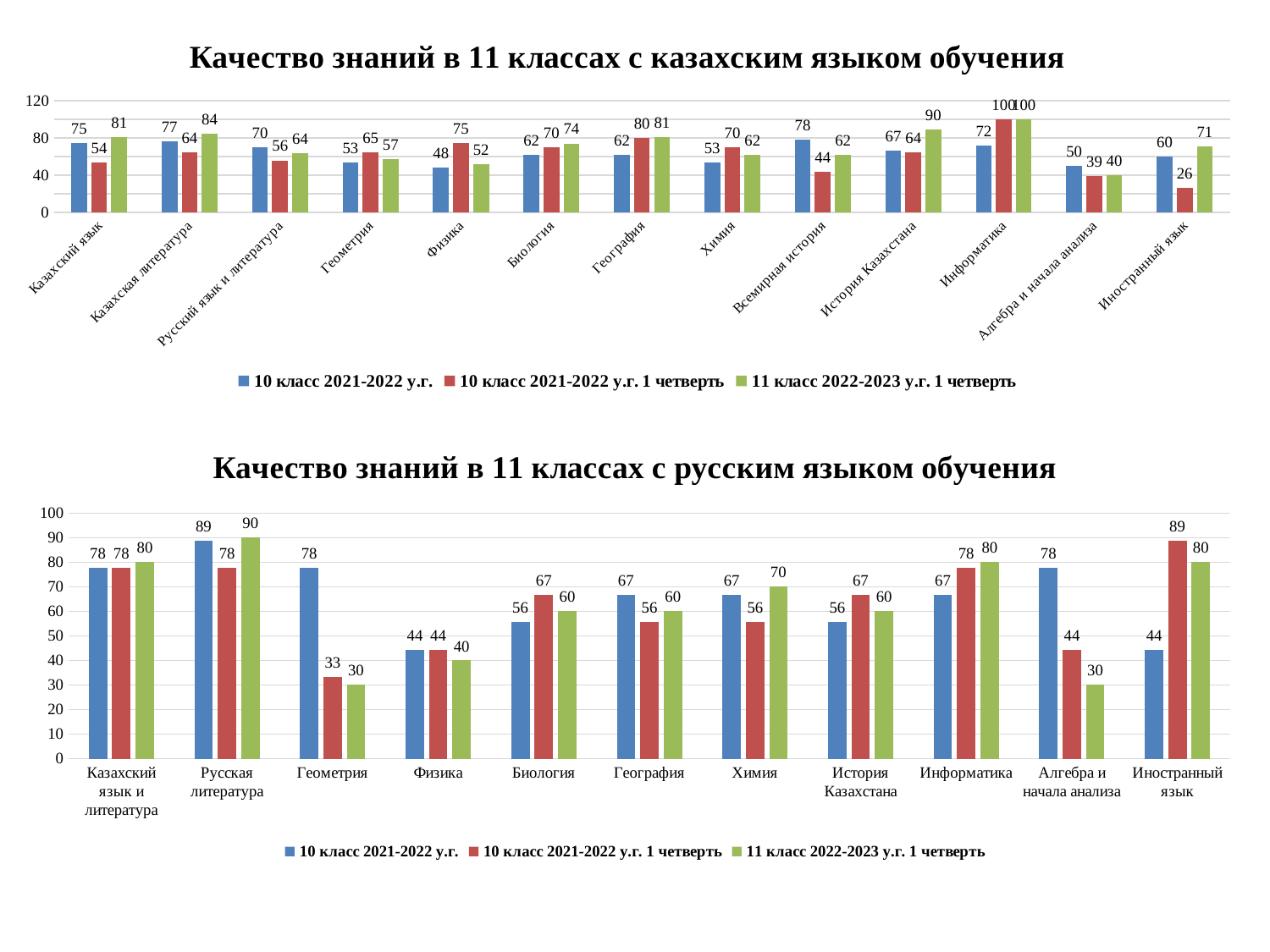
In the chart 'Качество знаний в 11 классах с казахским языком обучения', what is the value for Информатика in the series '10 класс 2021-2022 у.г.'? 72 How many series does the legend list in the chart 'Качество знаний в 11 классах с русским языком обучения'? 3 In the chart 'Качество знаний в 11 классах с казахским языком обучения', which category has the lowest value in the series '10 класс 2021-2022 у.г.'? Физика What type of chart is the bottom chart on the slide? Bar chart In the chart 'Качество знаний в 11 классах с казахским языком обучения', which category has the highest value in the series '11 класс 2022-2023 у.г. 1 четверть'? Информатика In the chart 'Качество знаний в 11 классах с русским языком обучения', which is larger for Иностранный язык: the '10 класс 2021-2022 у.г.' value or the '10 класс 2021-2022 у.г. 1 четверть' value? 10 класс 2021-2022 у.г. 1 четверть In the chart 'Качество знаний в 11 классах с казахским языком обучения', what is the value for Иностранный язык in the series '10 класс 2021-2022 у.г. 1 четверть'? 26 In the chart 'Качество знаний в 11 классах с русским языком обучения', which category has the highest value in the series '10 класс 2021-2022 у.г.'? Русская литература In the chart 'Качество знаний в 11 классах с русским языком обучения', what is the difference between the '10 класс 2021-2022 у.г.' and '11 класс 2022-2023 у.г. 1 четверть' values for Алгебра и начала анализа? 48 In the chart 'Качество знаний в 11 классах с русским языком обучения', what is the value for Геометрия in the series '11 класс 2022-2023 у.г. 1 четверть'? 30 How many categories are shown on the x axis of the chart 'Качество знаний в 11 классах с казахским языком обучения'? 13 In the chart 'Качество знаний в 11 классах с казахским языком обучения', what is the difference between the '11 класс 2022-2023 у.г. 1 четверть' and '10 класс 2021-2022 у.г. 1 четверть' values for История Казахстана? 26